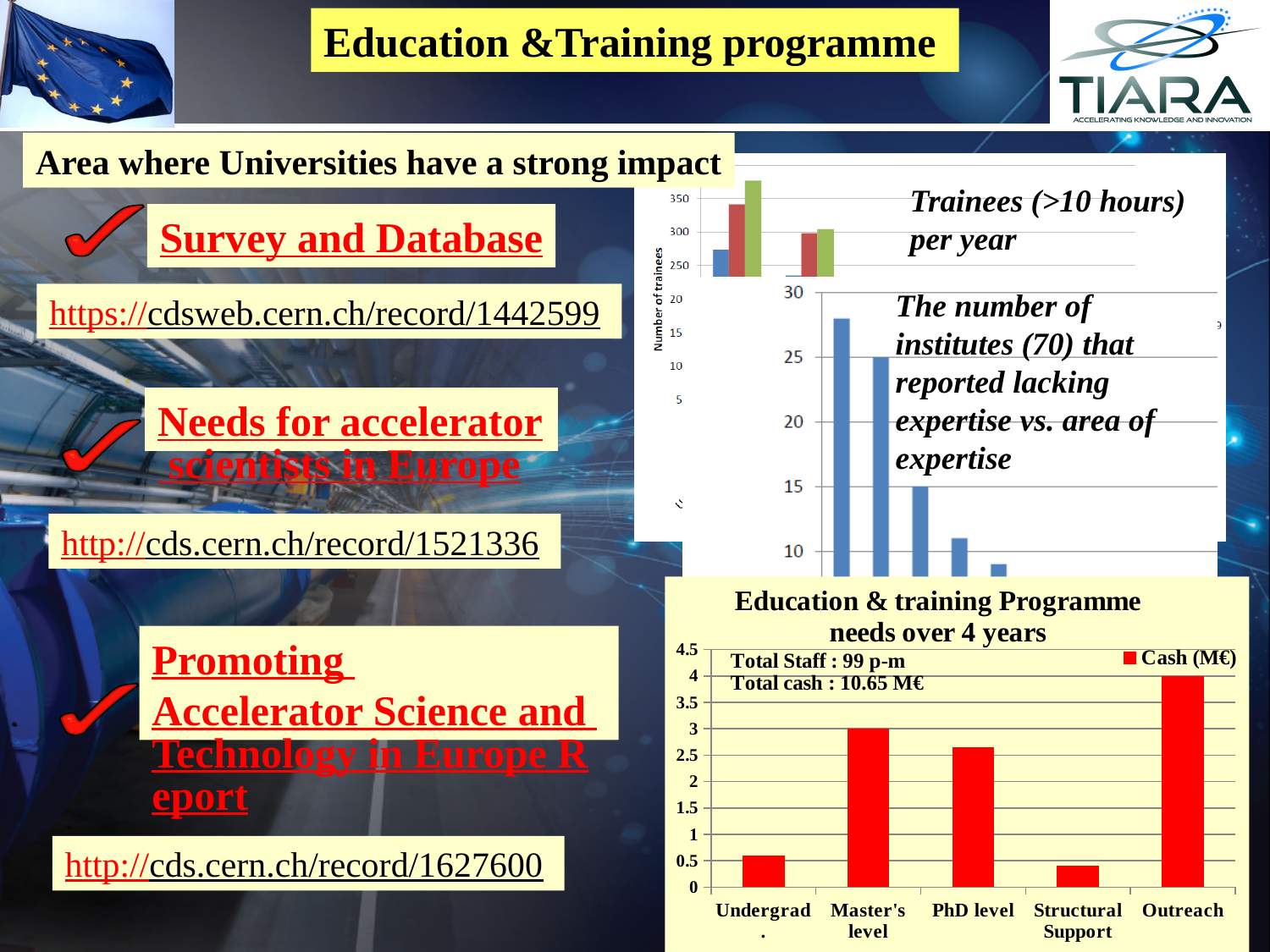
In the 'Education & training Programme needs over 4 years' chart, which is larger: Undergrad. or Structural Support? Undergrad. In the 'Education & training Programme needs over 4 years' chart, which category has the lowest value? Structural Support How many series does the legend of the 'Education & training Programme needs over 4 years' chart list? 1 In the 'Education & training Programme needs over 4 years' chart, which category has the highest value? Outreach What is the legend entry of the 'Education & training Programme needs over 4 years' chart? Cash (M€) In the 'Education & training Programme needs over 4 years' chart, is the value for Undergrad. greater or less than 1? less What kind of chart is the 'Education & training Programme needs over 4 years' chart? bar chart In the 'Education & training Programme needs over 4 years' chart, which is larger: Master's level or PhD level? Master's level In the 'Education & training Programme needs over 4 years' chart, is the value for PhD level greater or less than 2.5? greater How many categories are shown on the x axis of the 'Education & training Programme needs over 4 years' chart? 5 In the chart titled 'The number of institutes (70) that reported lacking expertise vs. area of expertise', do the bars rise or fall from left to right? fall In the 'Education & training Programme needs over 4 years' chart, is the value for Outreach greater or less than 3.5? greater